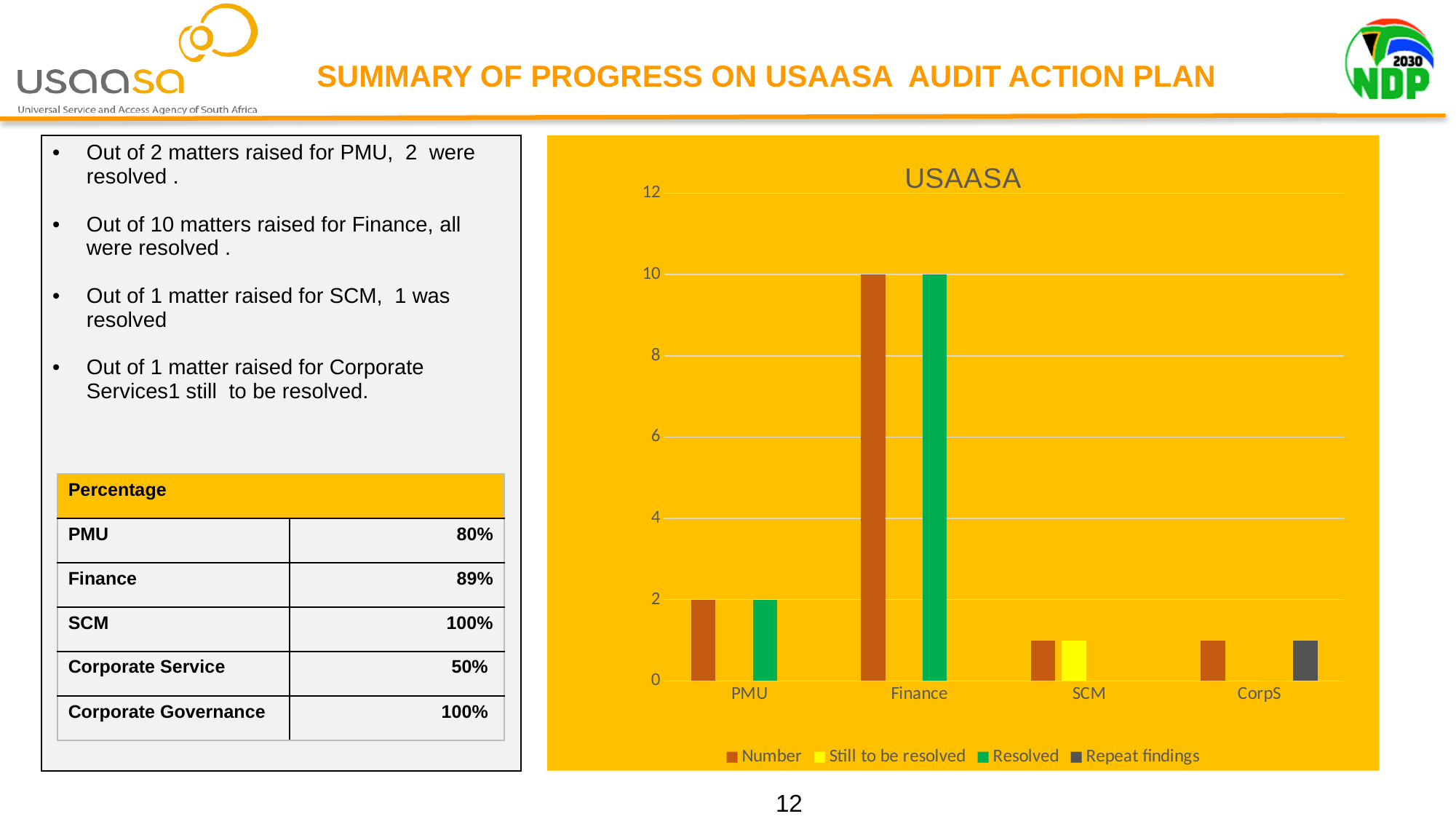
How many categories are shown on the x axis of the chart? 4 What kind of chart is shown on the slide? bar chart Which is larger: the Number value for Finance or the Number value for PMU? Finance What is the title of the chart? USAASA Which series is shown in green in the chart? Resolved What is the difference between the Number value for Finance and the Number value for PMU? 8 Is the value of the Resolved series for Finance greater or less than 8? greater What is the value of the Resolved series for PMU? 2 What is the value of the Number series for Finance? 10 Is the value of the Number series for SCM greater or less than 2? less Which category has the highest value for the Number series? Finance How many series does the chart legend list? 4